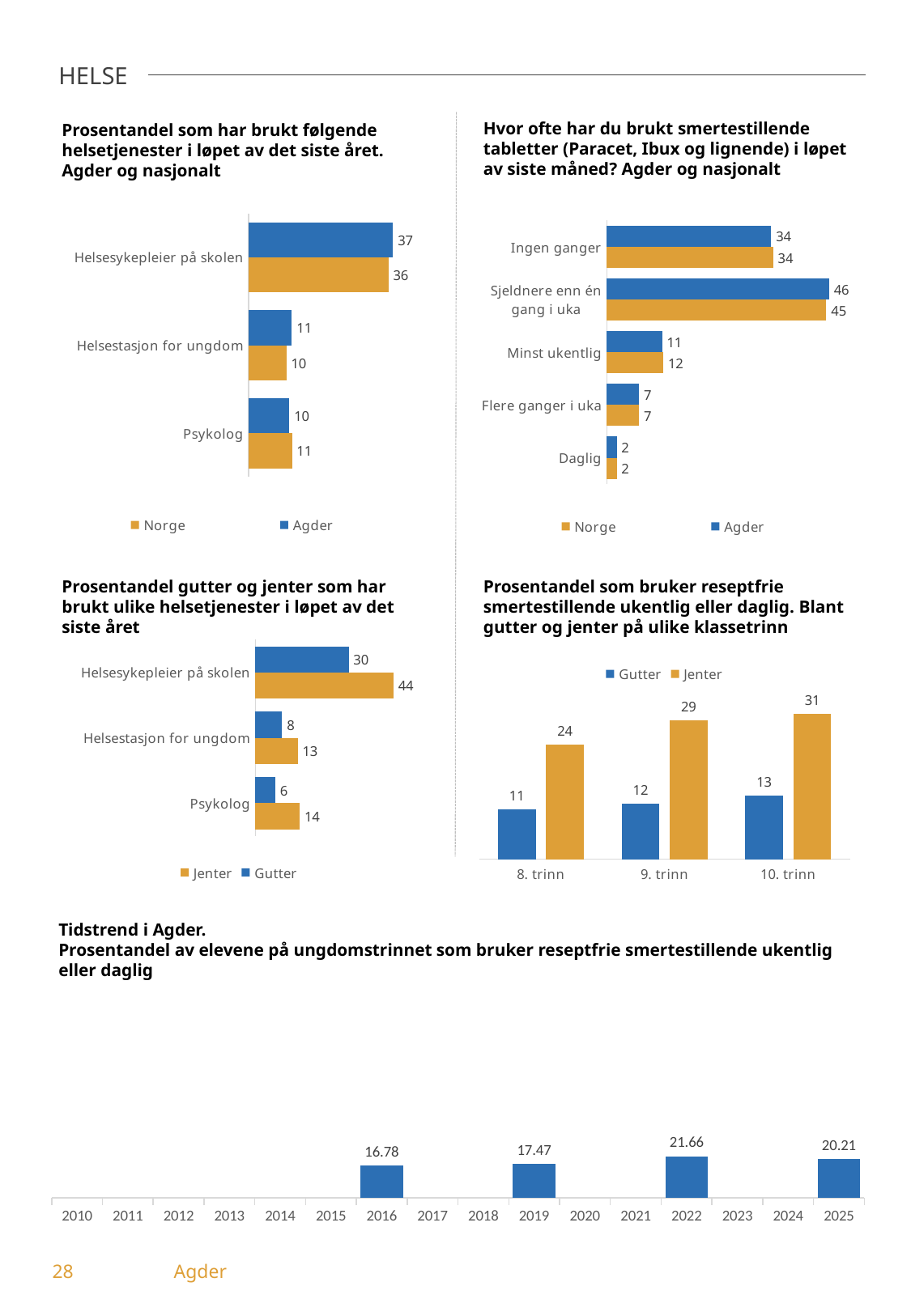
In the chart 'Hvor ofte har du brukt smertestillende tabletter (Paracet, Ibux og lignende) i løpet av siste måned? Agder og nasjonalt', which category has the highest value for Agder? Sjeldnere enn én gang i uka In the chart 'Prosentandel som bruker reseptfrie smertestillende ukentlig eller daglig. Blant gutter og jenter på ulike klassetrinn', do the values for Jenter rise or fall from 8. trinn to 10. trinn? rise In the chart 'Prosentandel som har brukt følgende helsetjenester i løpet av det siste året. Agder og nasjonalt', which category has the lowest value for Norge? Helsestasjon for ungdom In the chart 'Prosentandel gutter og jenter som har brukt ulike helsetjenester i løpet av det siste året', what is the value for Gutter for 'Psykolog'? 6 In the chart 'Prosentandel som har brukt følgende helsetjenester i løpet av det siste året. Agder og nasjonalt', what is the value for Agder for 'Helsesykepleier på skolen'? 37 In the chart 'Prosentandel som bruker reseptfrie smertestillende ukentlig eller daglig. Blant gutter og jenter på ulike klassetrinn', what is the value for Jenter in 10. trinn? 31 In the chart 'Hvor ofte har du brukt smertestillende tabletter (Paracet, Ibux og lignende) i løpet av siste måned? Agder og nasjonalt', how many categories are shown? 5 In the chart 'Tidstrend i Agder', what is the value for 2022? 21.66 In the chart 'Tidstrend i Agder', which year has the lowest value? 2016 In the chart 'Prosentandel som bruker reseptfrie smertestillende ukentlig eller daglig. Blant gutter og jenter på ulike klassetrinn', how many series does the legend list? 2 In the chart 'Hvor ofte har du brukt smertestillende tabletter (Paracet, Ibux og lignende) i løpet av siste måned? Agder og nasjonalt', what is the value for Norge for 'Sjeldnere enn én gang i uka'? 45 In the chart 'Prosentandel gutter og jenter som har brukt ulike helsetjenester i løpet av det siste året', what is the difference between Jenter and Gutter for 'Helsesykepleier på skolen'? 14